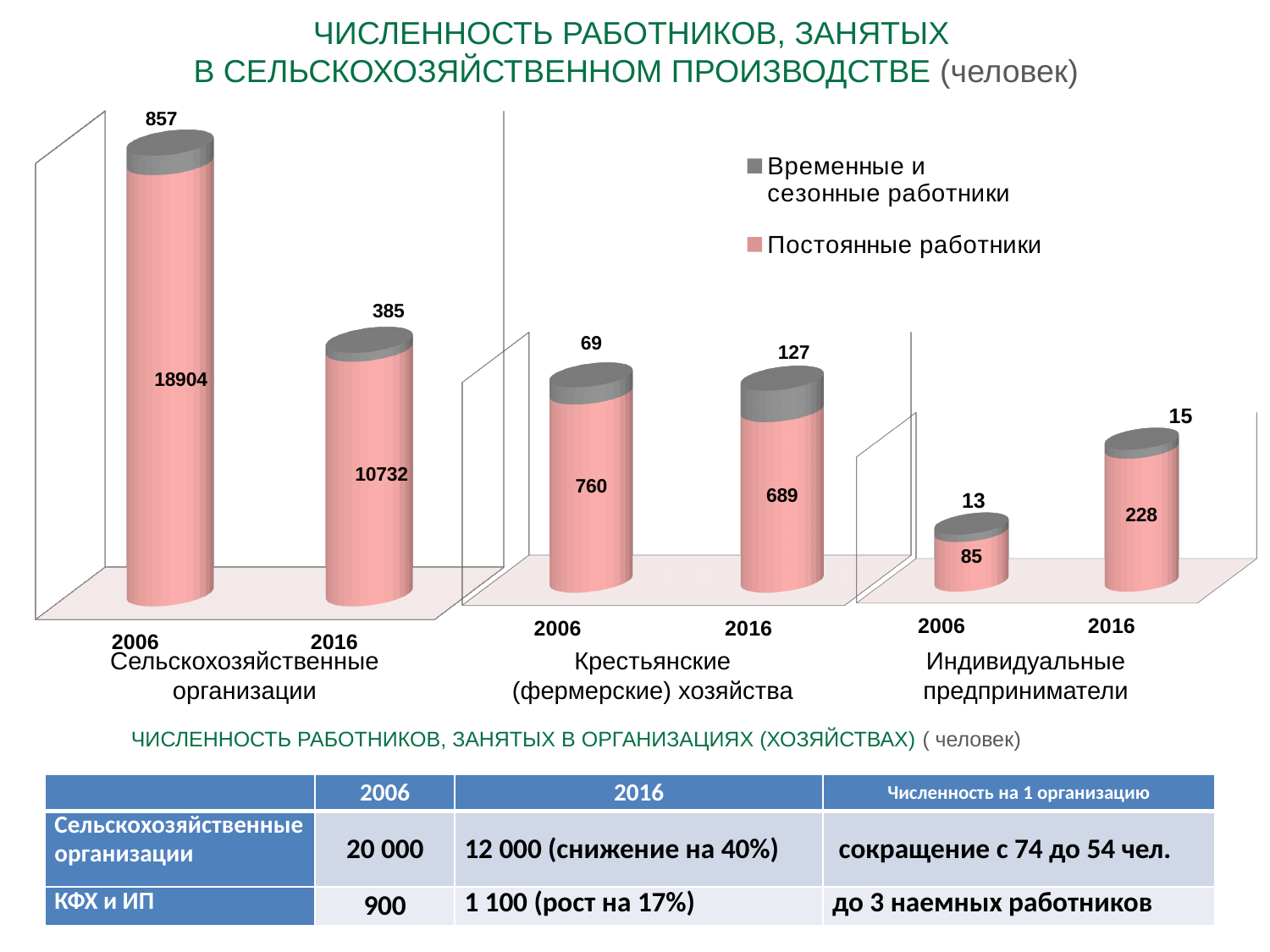
What is the number of permanent workers (Постоянные работники) in agricultural organisations (Сельскохозяйственные организации) in 2006? 18904 How many series does the chart legend list? 2 What is the number of temporary and seasonal workers in peasant (farm) households (Крестьянские (фермерские) хозяйства) in 2016? 127 What is the number of temporary and seasonal workers (Временные и сезонные работники) in agricultural organisations in 2016? 385 Which is larger: the number of permanent workers in peasant (farm) households in 2006 or in 2016? 2006 Which group and year has the lowest number of permanent workers? Индивидуальные предприниматели, 2006 Which group and year has the highest number of permanent workers? Сельскохозяйственные организации, 2006 What type of chart is shown on the slide? Stacked bar chart What is the total number of workers in agricultural organisations in 2016 (permanent plus temporary and seasonal)? 11117 How many permanent workers did individual entrepreneurs (Индивидуальные предприниматели) have in 2016? 228 By how much did the number of permanent workers in agricultural organisations fall from 2006 to 2016? 8172 What is the total number of workers for individual entrepreneurs in 2006? 98